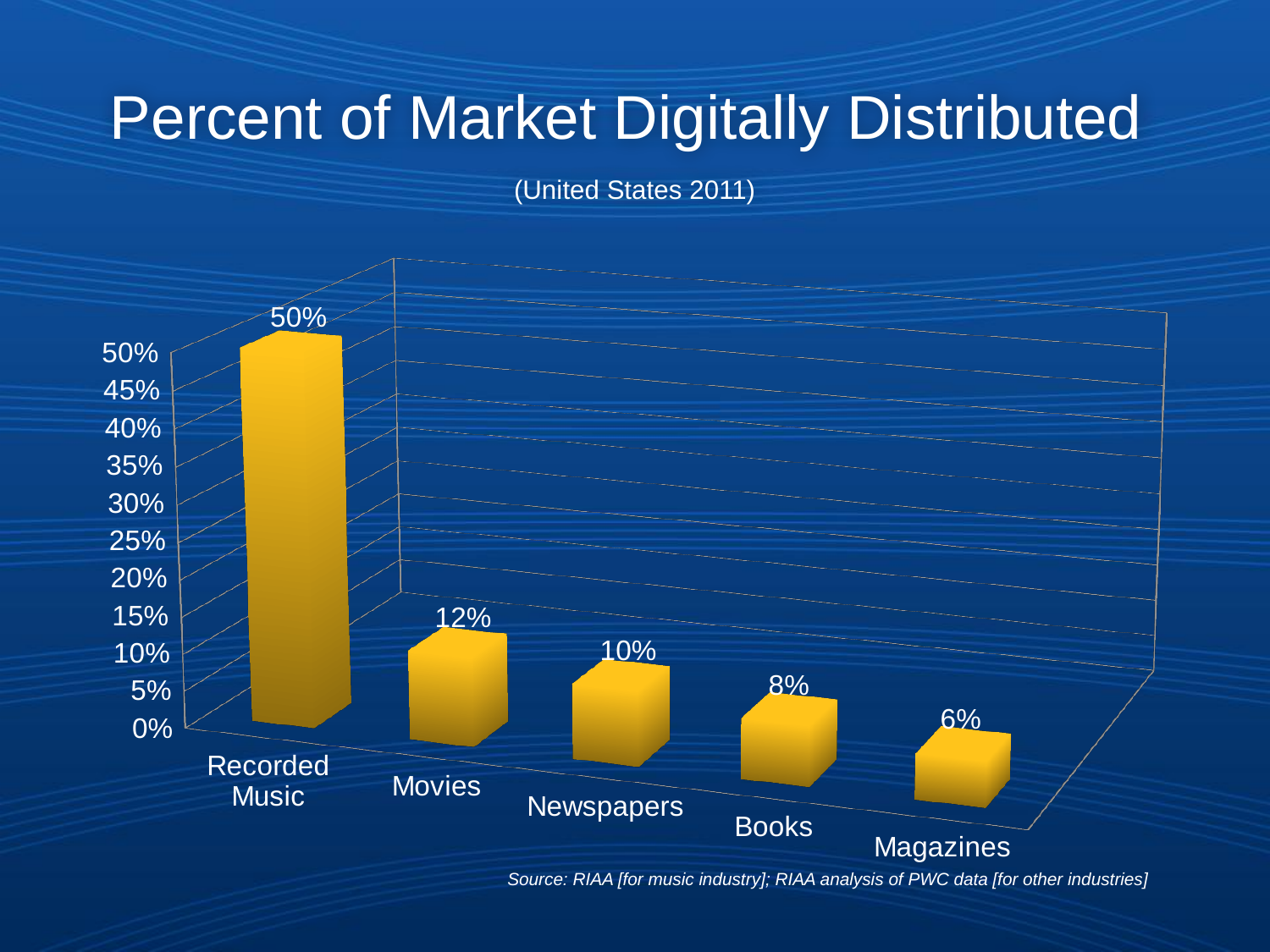
What percent of the recorded music market is digitally distributed? 50% Which is larger, the value for Newspapers or the value for Books? Newspapers Do the values rise or fall from left to right across the categories? Fall What is the difference between the values for Books and Magazines? 2% What kind of chart is shown on the slide? Bar chart Which category has the highest percent of market digitally distributed? Recorded Music What is the value shown for Newspapers? 10% What is the value shown for Movies? 12% What is the value shown for Magazines? 6% How many categories are shown in the chart? 5 Which category has the lowest percent of market digitally distributed? Magazines What is the difference between the values for Recorded Music and Movies? 38%